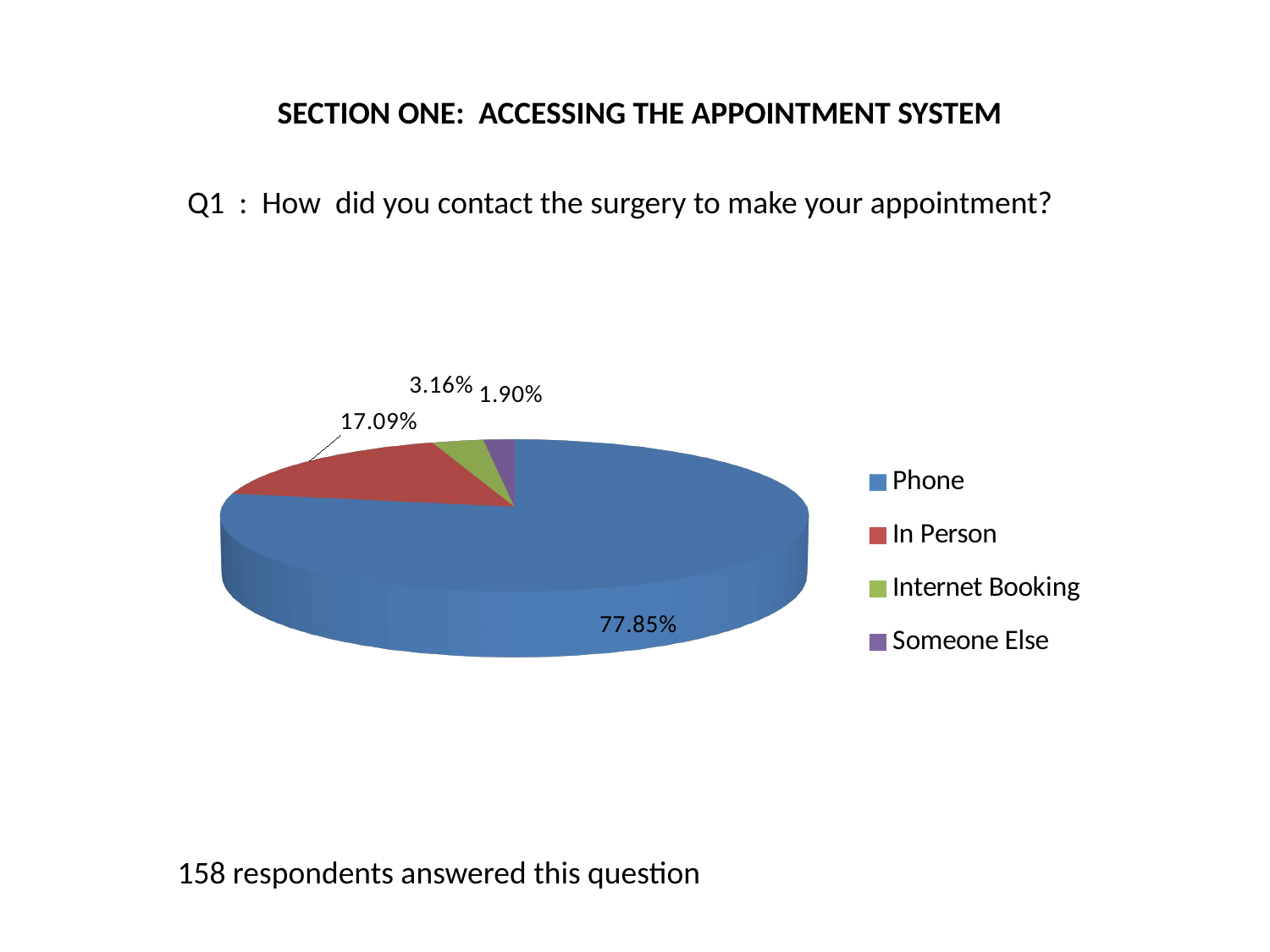
Which contact method has the smallest share of the pie? Someone Else How many respondents answered this question? 158 Which contact method has the largest share of the pie? Phone What percentage of respondents had Someone Else contact the surgery? 1.90% What percentage of respondents used Internet Booking? 3.16% What colour represents In Person in the pie chart? Red What is the difference in percentage points between Phone and In Person? 60.76 What type of chart is shown on the slide? Pie chart What percentage of respondents contacted the surgery In Person? 17.09% What percentage of respondents contacted the surgery by Phone? 77.85% Which is larger, the share for Internet Booking or the share for Someone Else? Internet Booking How many categories does the pie chart show? 4